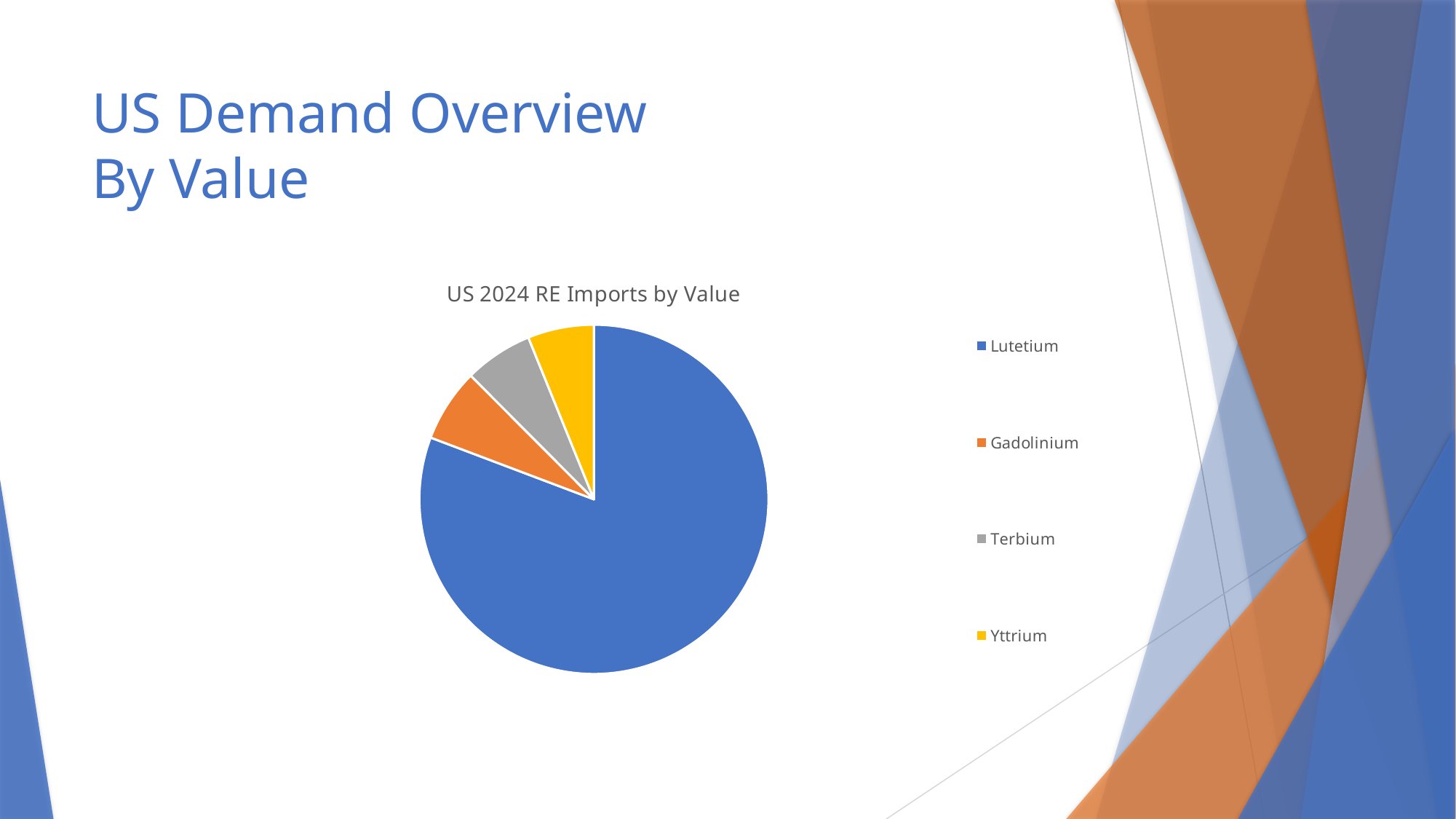
What colour is the Lutetium slice in the pie chart? Blue How many entries does the legend list? 4 What is the title of the chart? US 2024 RE Imports by Value How many categories (slices) does the pie chart have? 4 Which category is shown in yellow in the pie chart? Yttrium Which is larger, the slice for Lutetium or the slice for Gadolinium? Lutetium Which category has the largest share of the pie? Lutetium Which is larger, the slice for Lutetium or the slice for Yttrium? Lutetium What kind of chart is shown on the slide? Pie chart Which is larger, the slice for Terbium or the slice for Lutetium? Lutetium